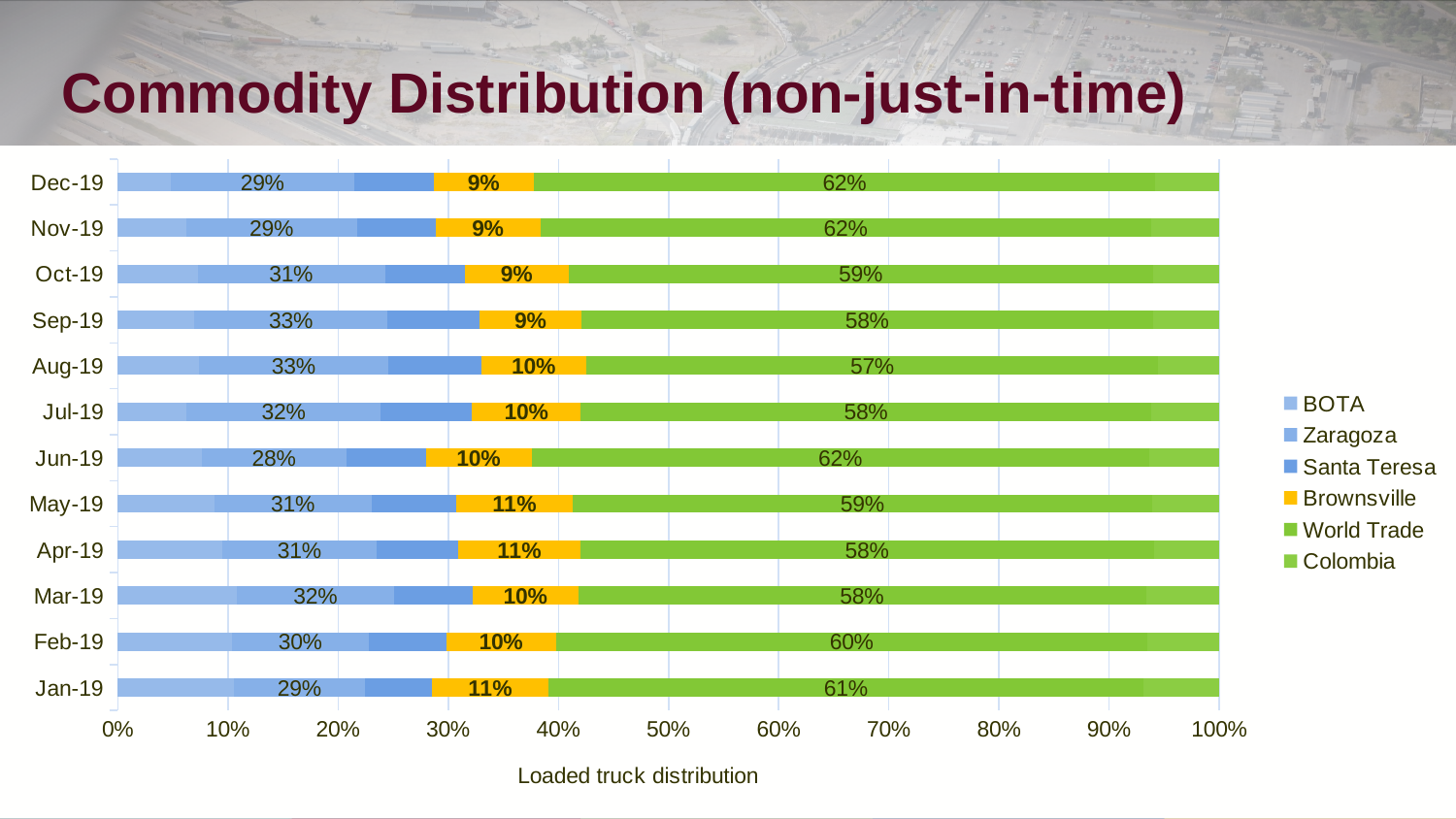
By how many percentage points does the Brownsville value for Jan-19 exceed the Brownsville value for Dec-19? 2 percentage points What is the Brownsville (yellow) value for Aug-19? 10% What is the title of the horizontal axis? Loaded truck distribution How many series does the legend list? 6 What percentage label is shown on the green portion of the Dec-19 bar? 62% Does the Brownsville (yellow) value rise or fall from Jan-19 to Dec-19? Fall What is the Brownsville (yellow) value for Jan-19? 11% How many months are shown on the vertical axis? 12 Which month has the larger Brownsville (yellow) value, Apr-19 or Oct-19? Apr-19 What is the Brownsville (yellow) value for Dec-19? 9% What kind of chart is shown on the slide? Stacked bar chart What percentage label is shown on the blue portion of the Jun-19 bar? 28%